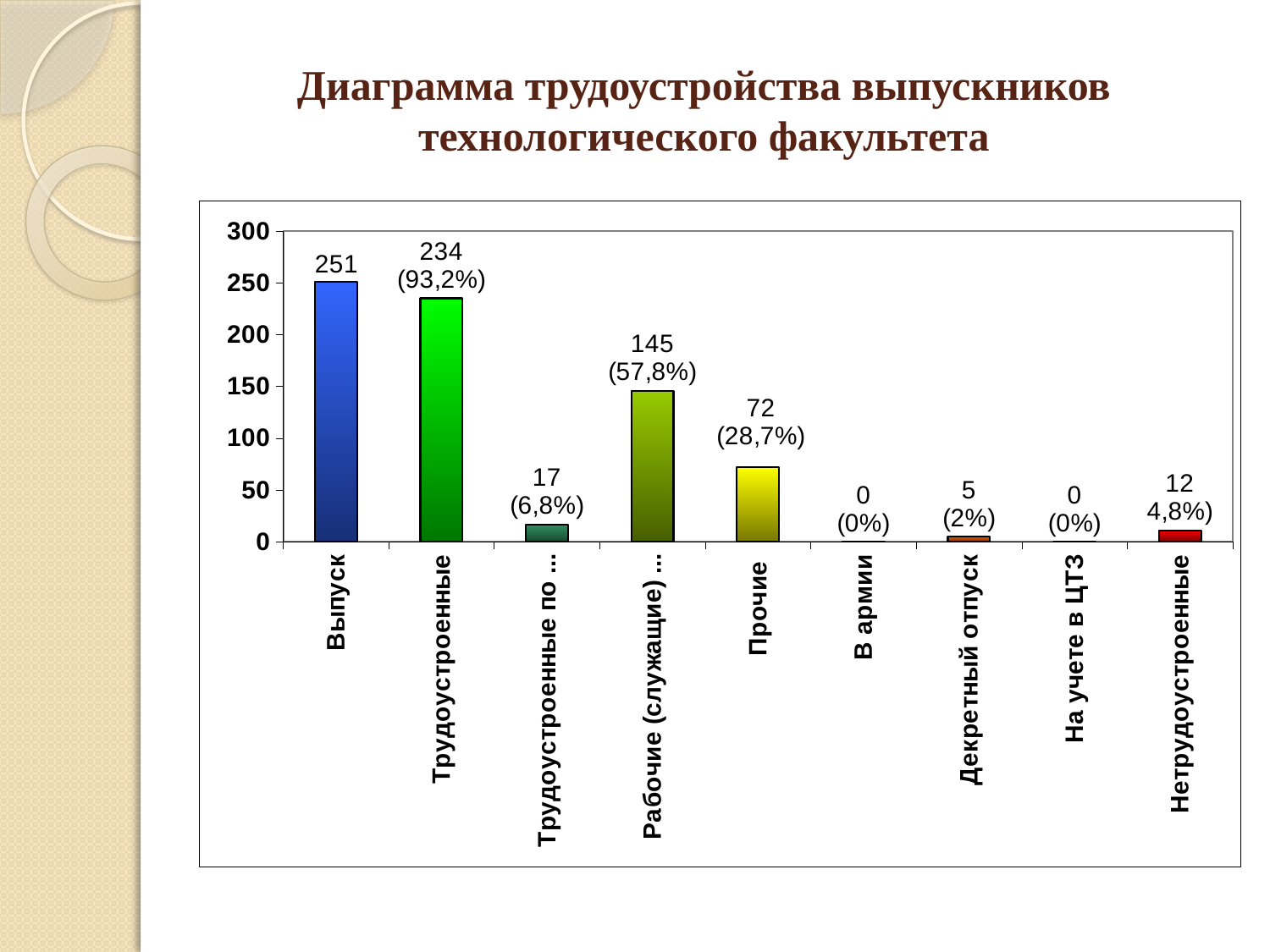
What kind of chart is shown on the slide? bar chart Which category has the highest value? Выпуск What is the value for Декретный отпуск? 5 What is the difference between the values for Выпуск and Трудоустроенные? 17 What percentage is shown for Трудоустроенные? 93,2% What is the value for Выпуск? 251 Which is larger, the value for Прочие or the value for Нетрудоустроенные? Прочие What is the value for Трудоустроенные? 234 What is the value for Прочие? 72 What is the value for Нетрудоустроенные? 12 What is the value for В армии? 0 How many categories are shown on the x axis? 9